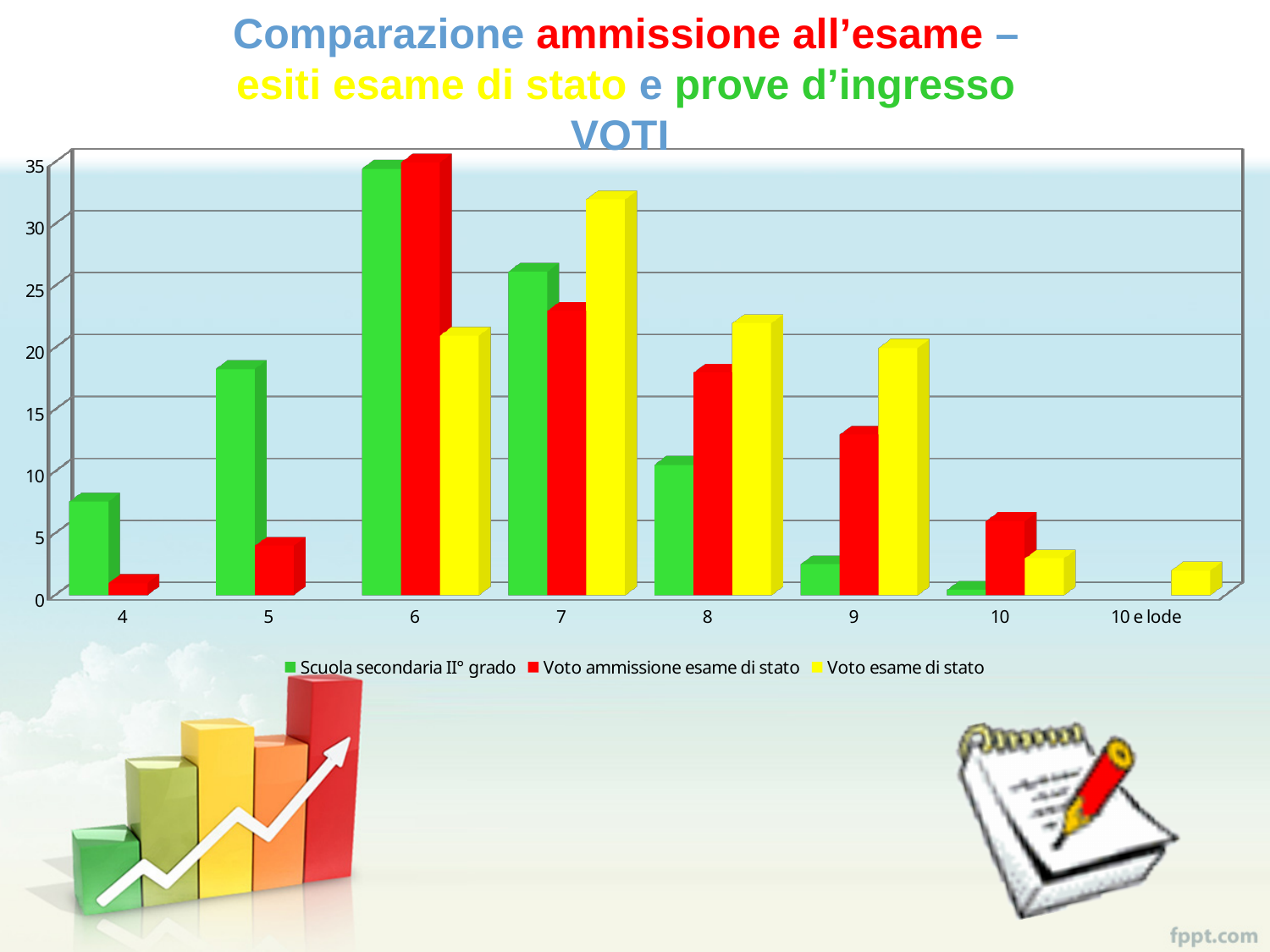
Which category has the highest value for the Voto esame di stato series? 7 How many categories are shown on the x axis of the chart? 8 At category 8, which series has the larger value: Scuola secondaria II° grado or Voto esame di stato? Voto esame di stato At category 4, which series has the larger value: Scuola secondaria II° grado or Voto ammissione esame di stato? Scuola secondaria II° grado How many series does the chart legend list? 3 Is the value for Voto ammissione esame di stato at category 9 greater or less than 15? less Is the value for Voto esame di stato at category 8 greater or less than 20? greater Is the value for Scuola secondaria II° grado at category 5 greater or less than 15? greater Which category has the highest value for the Voto ammissione esame di stato series? 6 What kind of chart is shown on the slide? bar chart What colour represents the Voto esame di stato series in the chart? yellow Which category has the highest value for the Scuola secondaria II° grado series? 6